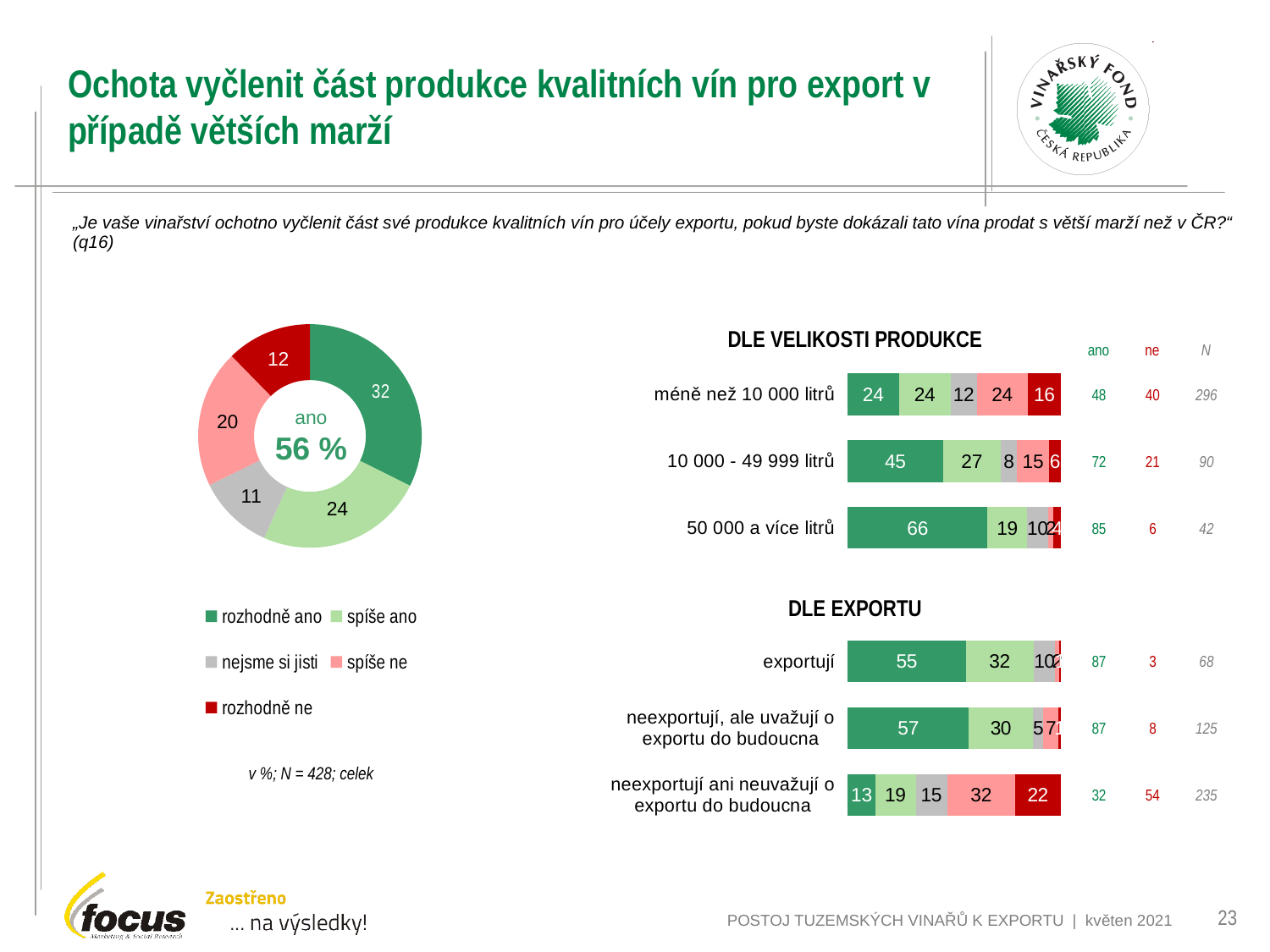
In the "DLE EXPORTU" chart, what is the "spíše ne" value for "neexportují ani neuvažují o exportu do budoucna"? 32 In the donut chart on the left, what is the value for "rozhodně ano"? 32 In the "DLE VELIKOSTI PRODUKCE" chart, what is the "rozhodně ne" value for "méně než 10 000 litrů"? 16 In the "DLE VELIKOSTI PRODUKCE" chart, which category has the largest "rozhodně ano" segment? 50 000 a více litrů In the donut chart on the left, what is the value for "nejsme si jisti"? 11 In the donut chart on the left, what is the difference between "spíše ano" and "rozhodně ne"? 12 In the "DLE EXPORTU" chart, is the "rozhodně ano" value for "exportují" larger or smaller than for "neexportují, ale uvažují o exportu do budoucna"? smaller In the donut chart on the left, which category has the highest value? rozhodně ano In the donut chart on the left, which category has the lowest value? nejsme si jisti How many categories does the legend of the donut chart on the left list? 5 What type of chart is used for the "DLE EXPORTU" section? stacked bar chart In the "DLE VELIKOSTI PRODUKCE" chart, what is the "rozhodně ano" value for "10 000 - 49 999 litrů"? 45